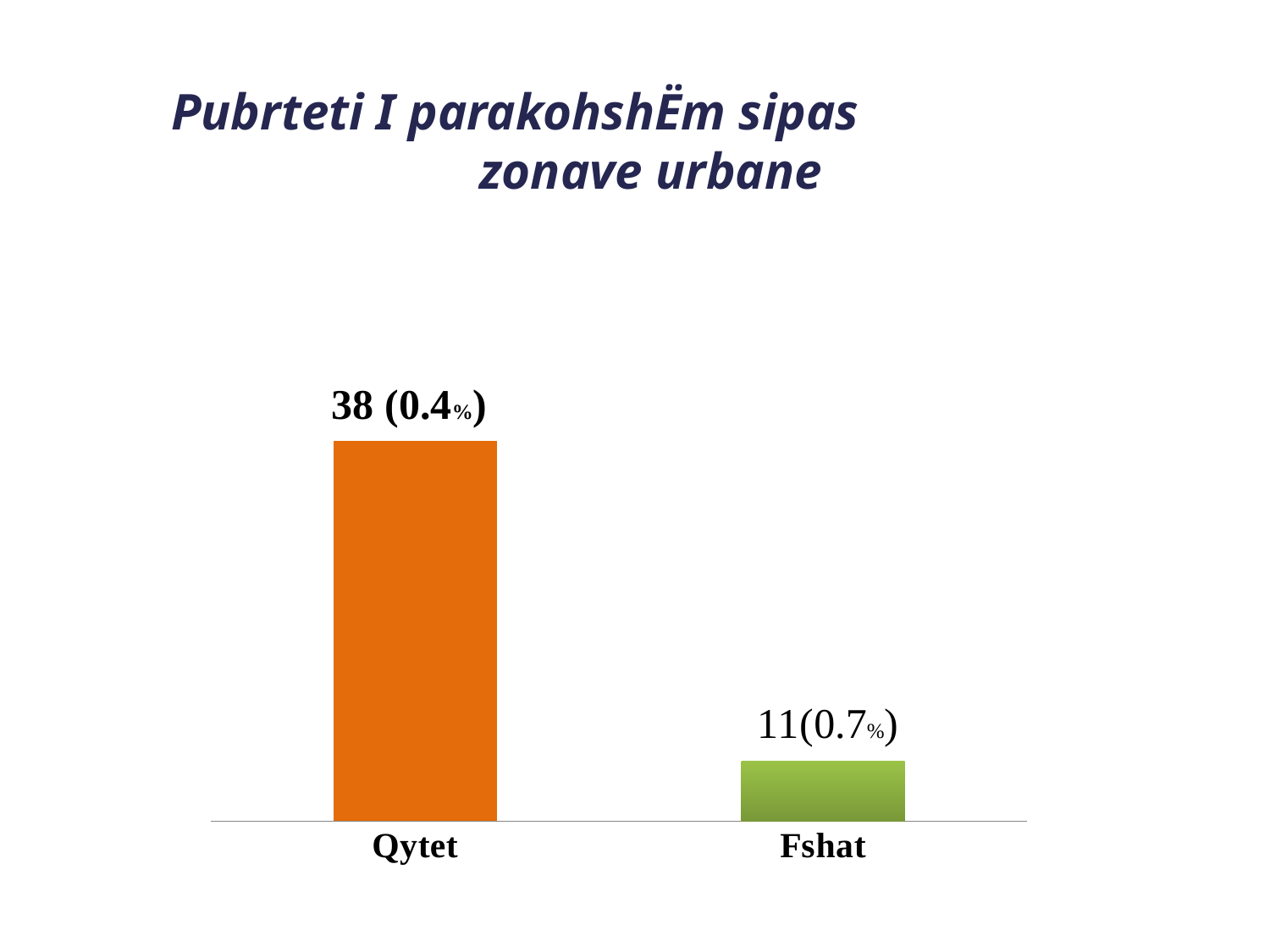
What percentage is shown in parentheses for Fshat? 0.7% What is the value shown for Fshat? 11(0.7%) What percentage is shown in parentheses for Qytet? 0.4% What colour is the bar for Fshat? Green What is the difference between the count for Qytet and the count for Fshat? 27 Which has a larger count, Qytet or Fshat? Qytet Which category has the lowest bar? Fshat What colour is the bar for Qytet? Orange What is the value shown for Qytet? 38 (0.4%) Which category has the highest bar? Qytet What kind of chart is shown on the slide? Bar chart How many categories are shown on the chart? 2